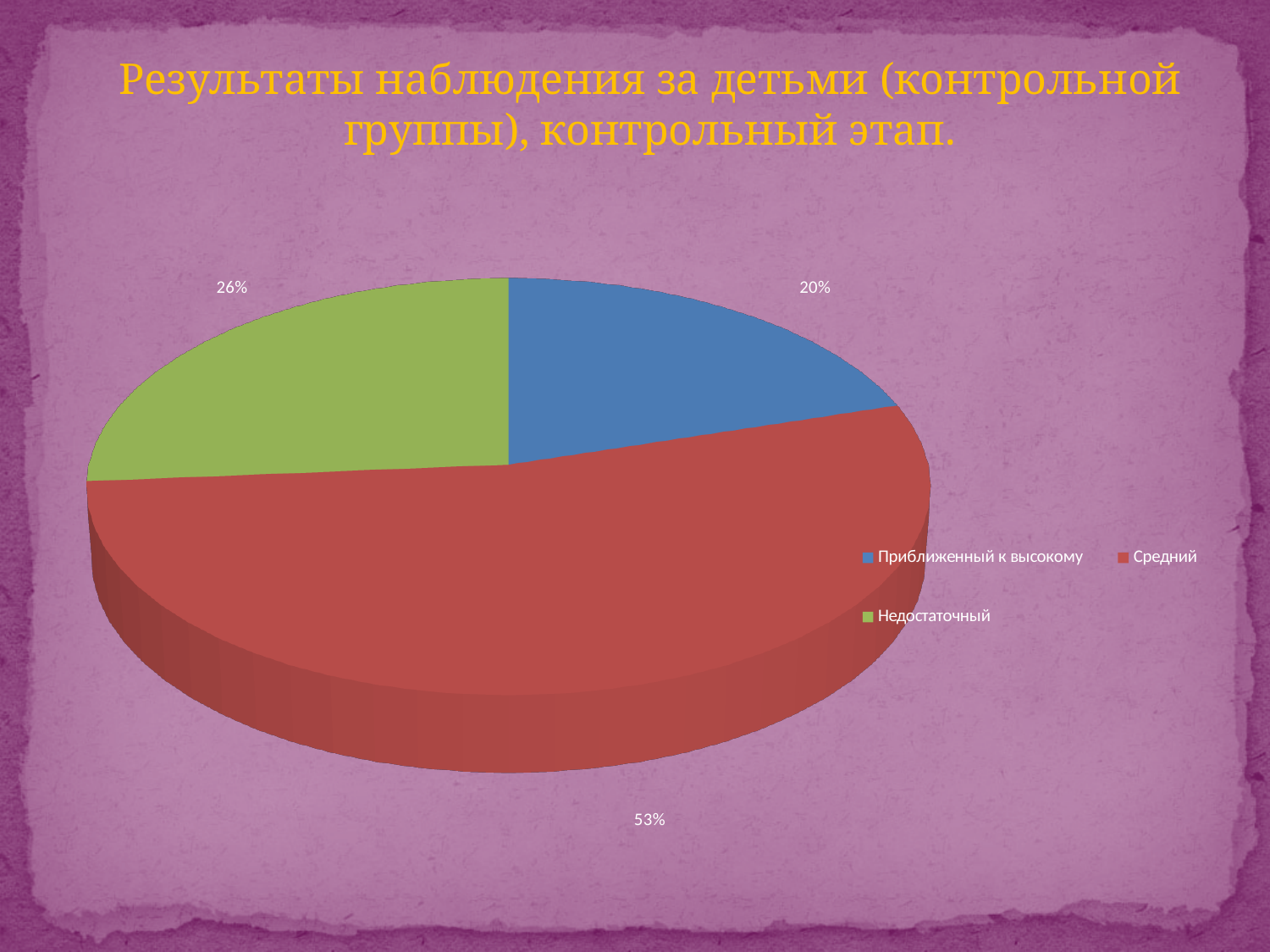
What colour is the slice for "Средний"? red Which category has the largest slice of the pie? Средний Which category has the smallest slice of the pie? Приближенный к высокому What kind of chart is shown on the slide? pie chart What is the difference in percentage points between "Средний" and "Недостаточный"? 27 What share of the pie does "Недостаточный" have? 26% How many slices does the pie chart have? 3 What share of the pie does "Приближенный к высокому" have? 20% What is the title of the slide? Результаты наблюдения за детьми (контрольной группы), контрольный этап. Which is larger, the slice for "Недостаточный" or the slice for "Приближенный к высокому"? Недостаточный How many entries does the legend list? 3 What share of the pie does "Средний" have? 53%